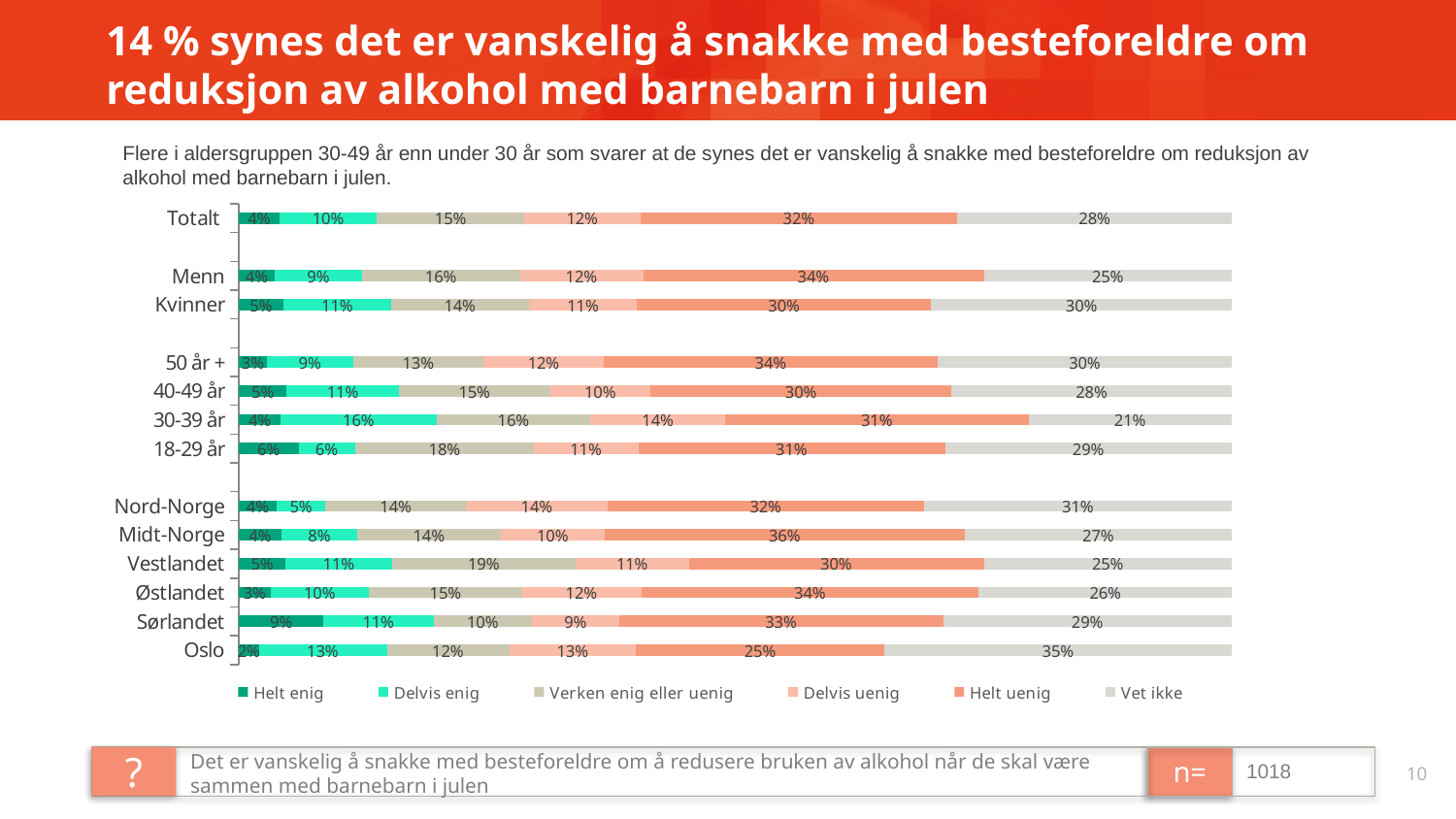
What is the last entry in the chart's legend? Vet ikke Which has a larger "Verken enig eller uenig" value, Vestlandet or Sørlandet? Vestlandet What is the difference between the "Vet ikke" values for Kvinner and Menn? 5% What percentage of Totalt answered "Helt uenig"? 32% What kind of chart is shown on the slide? Stacked bar chart What percentage of 30-39 år answered "Delvis enig"? 16% How many series does the legend list? 6 What is the total of all segments in the Oslo bar? 100% How many categories are shown on the y axis of the chart? 13 Which category has the highest "Helt uenig" value? Midt-Norge Which category has the lowest "Helt enig" value? Oslo What is the "Vet ikke" value for Oslo? 35%